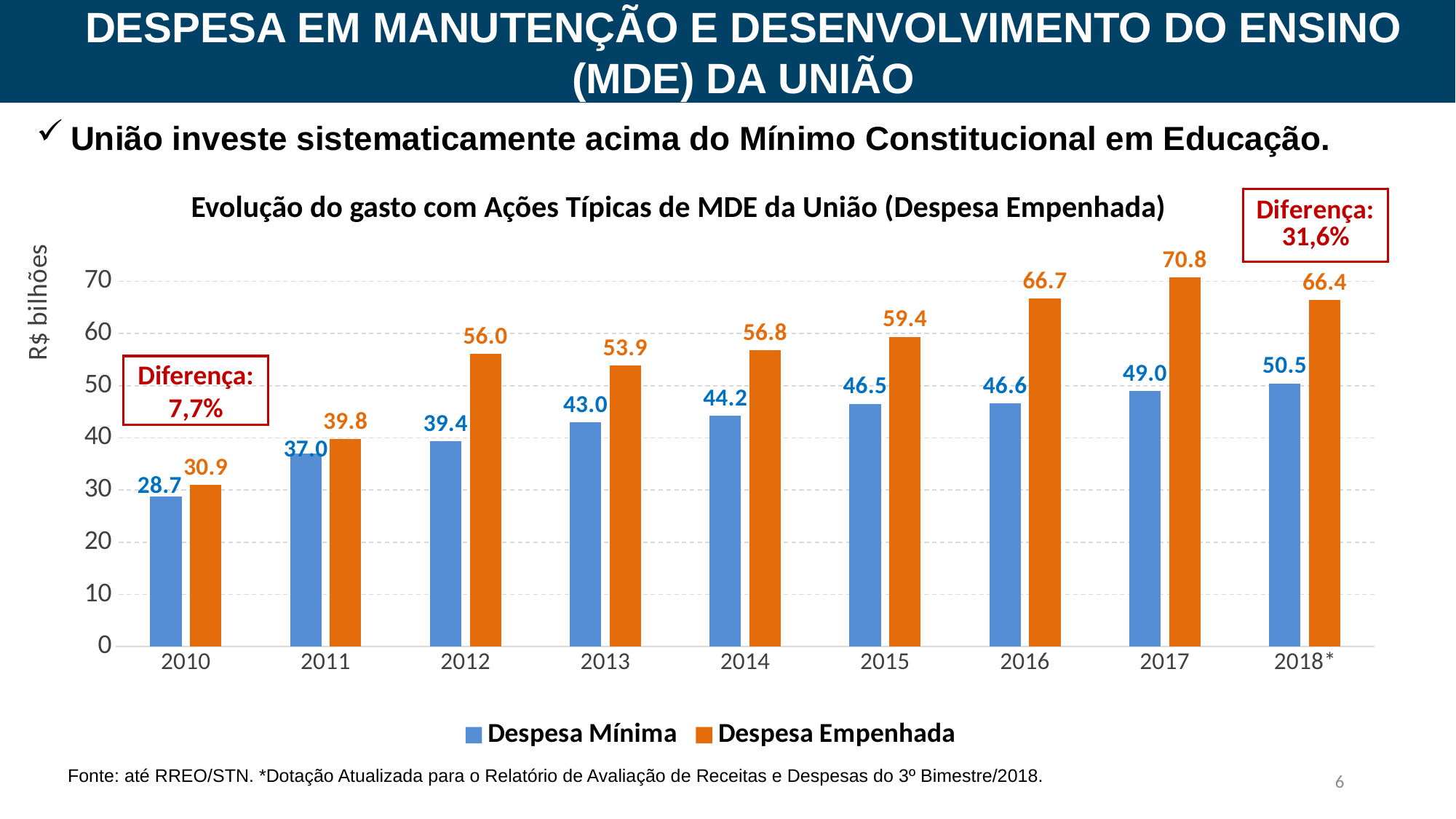
What is the value of Despesa Empenhada for 2012? 56.0 What is the difference between Despesa Empenhada and Despesa Mínima in 2016? 20.1 Is the Despesa Empenhada value for 2015 greater or less than 50? greater Does Despesa Mínima rise or fall from 2010 to 2018*? Rise How many years are shown on the x axis? 9 What kind of chart is shown on the slide? Bar chart Which year has the lowest Despesa Mínima value? 2010 How many series does the legend list? 2 What is the value of Despesa Mínima for 2010? 28.7 Which year has the highest Despesa Empenhada value? 2017 What is the value of Despesa Empenhada for 2017? 70.8 Which is larger in 2013: Despesa Mínima or Despesa Empenhada? Despesa Empenhada